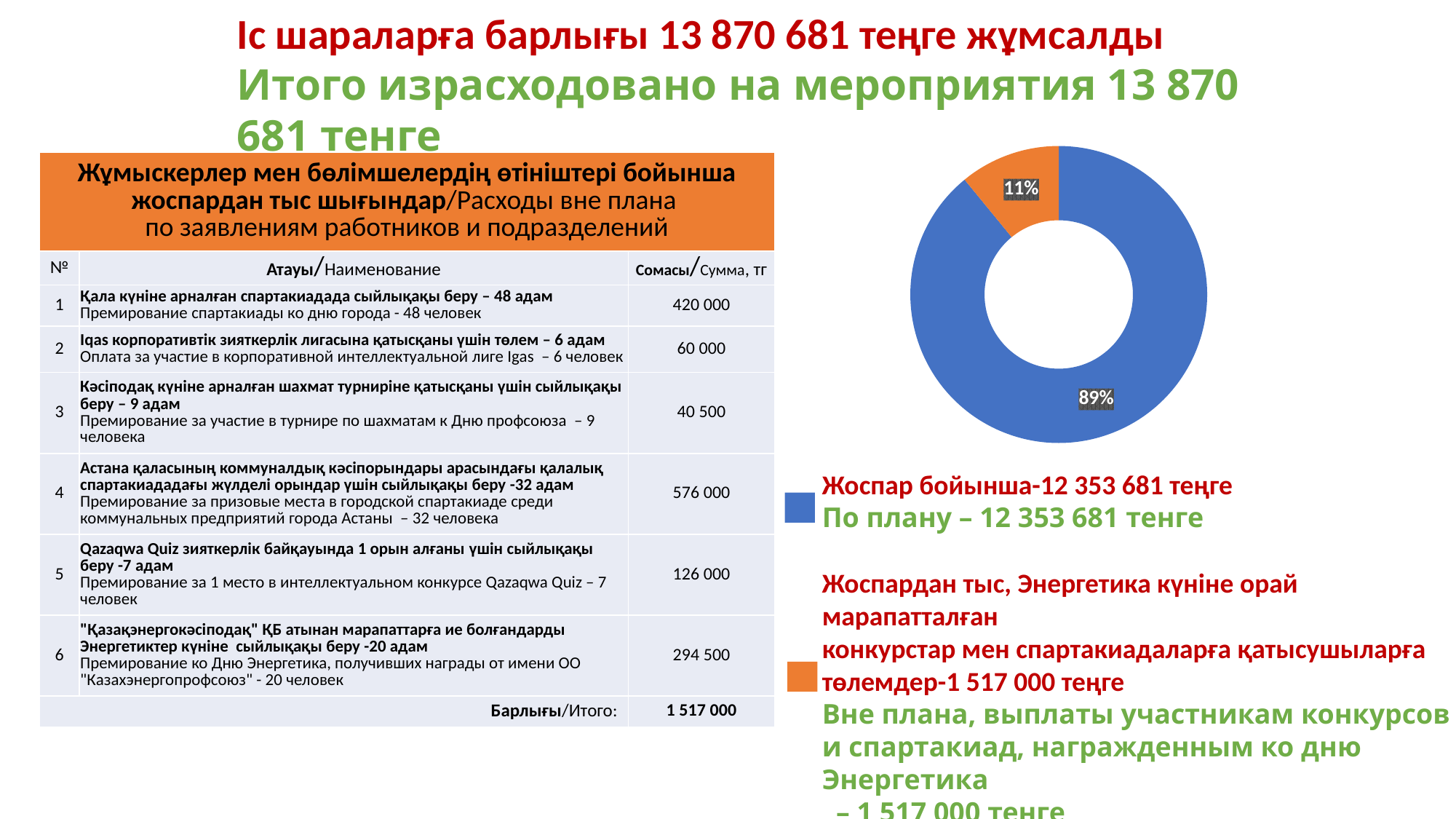
What is the difference in percentage points between the 89% slice and the 11% slice of the doughnut chart? 78 percentage points What share of the doughnut chart does the orange slice (Вне плана / Жоспардан тыс) represent? 11% Which is larger in the doughnut chart: the planned (По плану) share or the unplanned (Вне плана) share? По плану What kind of chart is shown on the right side of the slide? Doughnut (pie) chart According to the legend text next to the doughnut chart, what amount corresponds to the orange slice (Вне плана)? 1 517 000 тенге What is the total of the two amounts shown for the doughnut chart slices (12 353 681 and 1 517 000)? 13 870 681 тенге Which slice of the doughnut chart is the largest? По плану (blue), 89% What share of the doughnut chart does the blue slice (По плану / Жоспар бойынша) represent? 89% According to the legend text next to the doughnut chart, what amount corresponds to the blue slice (По плану)? 12 353 681 тенге What colour is used for the 'Вне плана' (unplanned) slice in the doughnut chart? Orange How many slices does the doughnut chart have? 2 Which slice of the doughnut chart is the smallest? Вне плана (orange), 11%